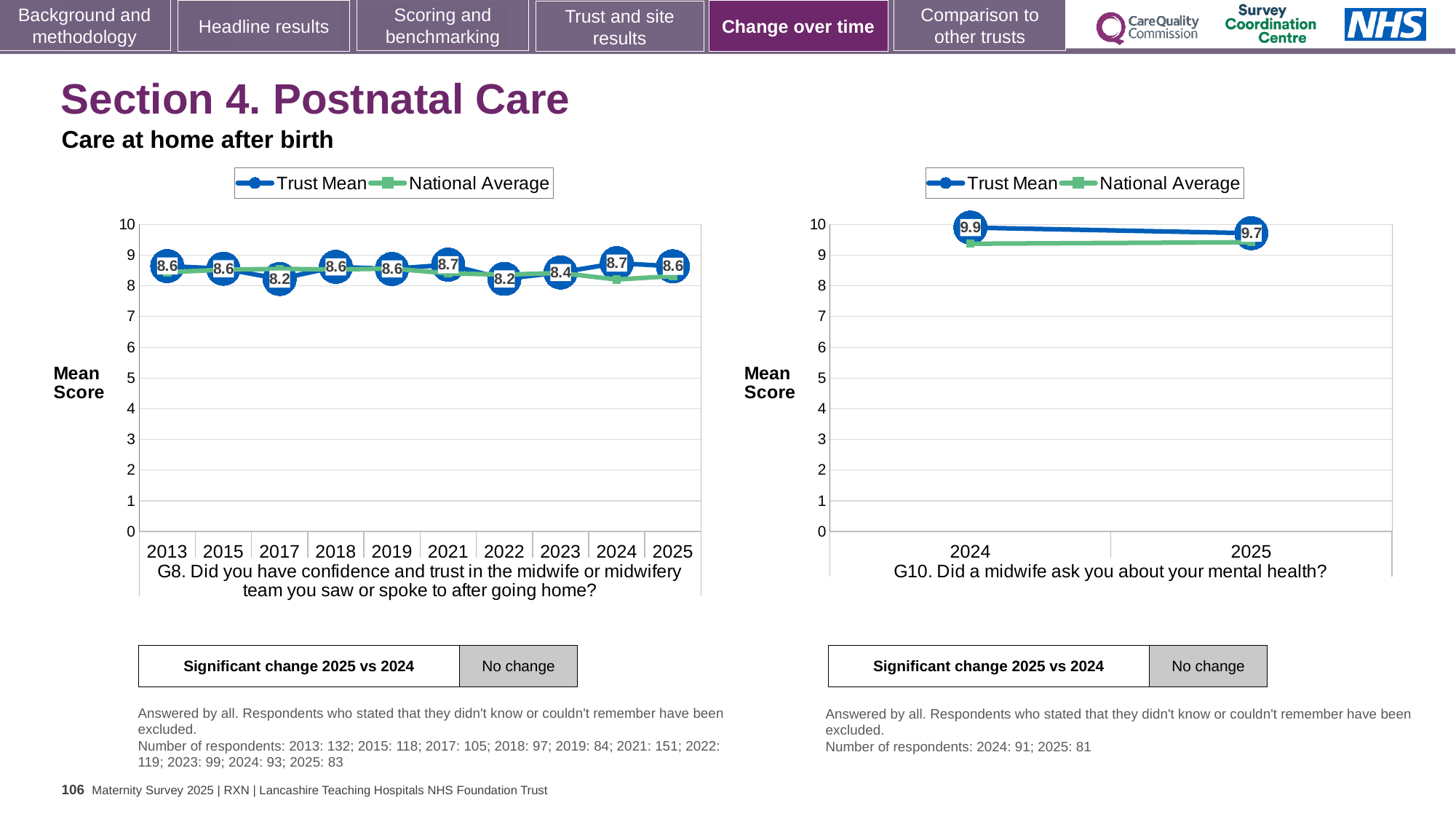
In the G8 chart on the left, what is the Trust Mean score for 2017? 8.2 How many series does the legend of the G10 chart on the right list? 2 What kind of chart is the G8 chart on the left? Line chart What are the two series named in the legend of the G8 chart on the left? Trust Mean and National Average In the G10 chart on the right, what is the difference between the Trust Mean scores for 2024 and 2025? 0.2 How many years are plotted on the x axis of the G8 chart on the left? 10 In the G8 chart on the left, what is the Trust Mean score for 2024? 8.7 In the G8 chart on the left, which year has the larger Trust Mean score, 2021 or 2022? 2021 In the G10 chart on the right, what is the Trust Mean score for 2024? 9.9 In the G10 chart on the right, does the Trust Mean rise or fall from 2024 to 2025? Fall In the G10 chart on the right, what is the Trust Mean score for 2025? 9.7 In the G10 chart on the right, is the National Average value for 2024 greater or less than 9? greater